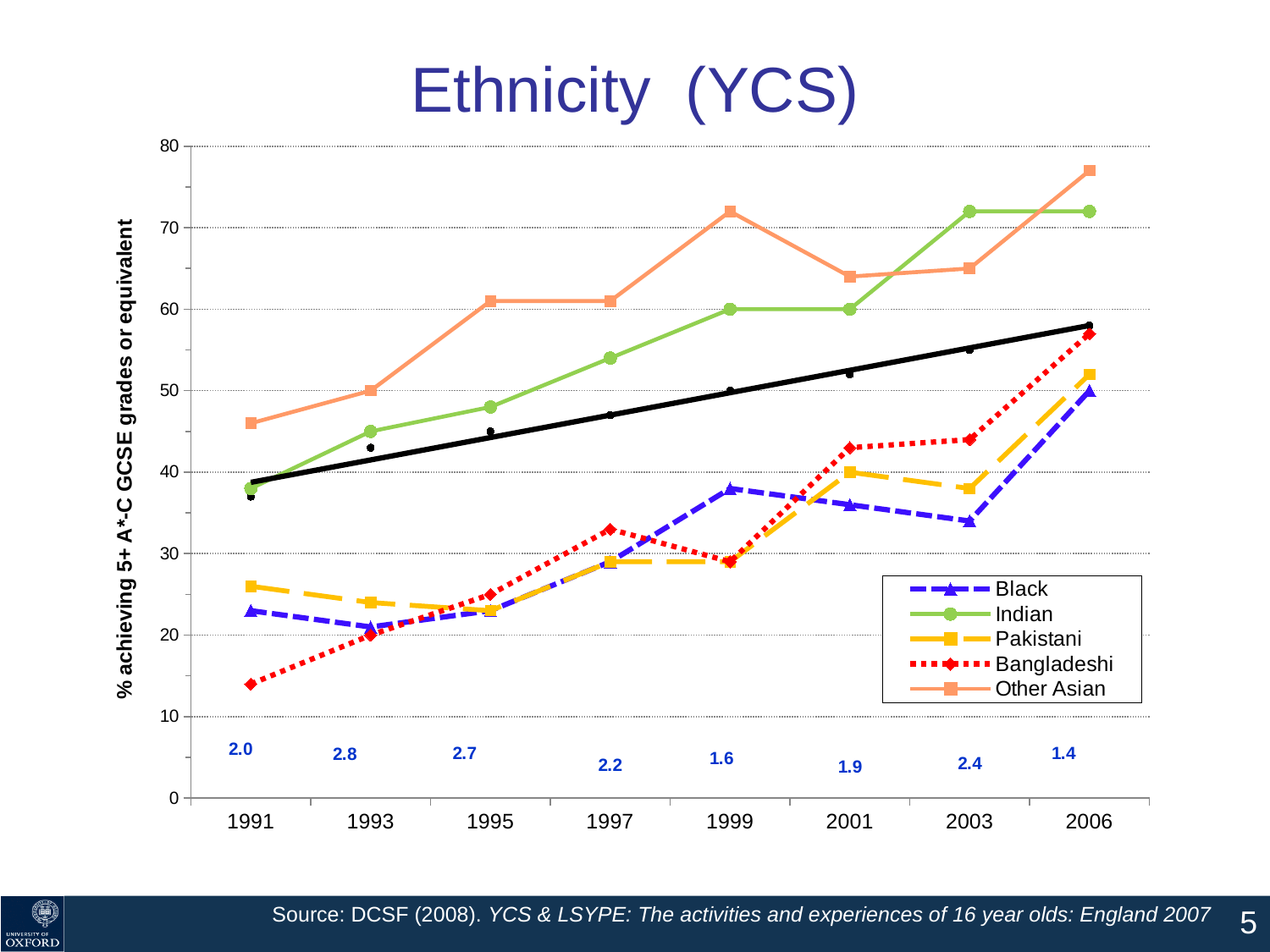
Which ethnic group has the highest value in 2006? Other Asian Which ethnic group has the lowest value in 1991? Bangladeshi Is the value for Bangladeshi in 1991 greater or less than 20? less What kind of chart is shown on the slide? line chart In 2001, which is larger, the value for Bangladeshi or the value for Black? Bangladeshi How many series does the legend list? 5 In 1999, which is larger, the value for Indian or the value for Black? Indian Is the value for Indian in 2003 greater or less than 70? greater How many years are shown on the x axis? 8 What is the label on the y axis? % achieving 5+ A*-C GCSE grades or equivalent Is the value for Other Asian in 2006 greater or less than 70? greater Does the Indian series generally rise or fall from 1991 to 2006? rise